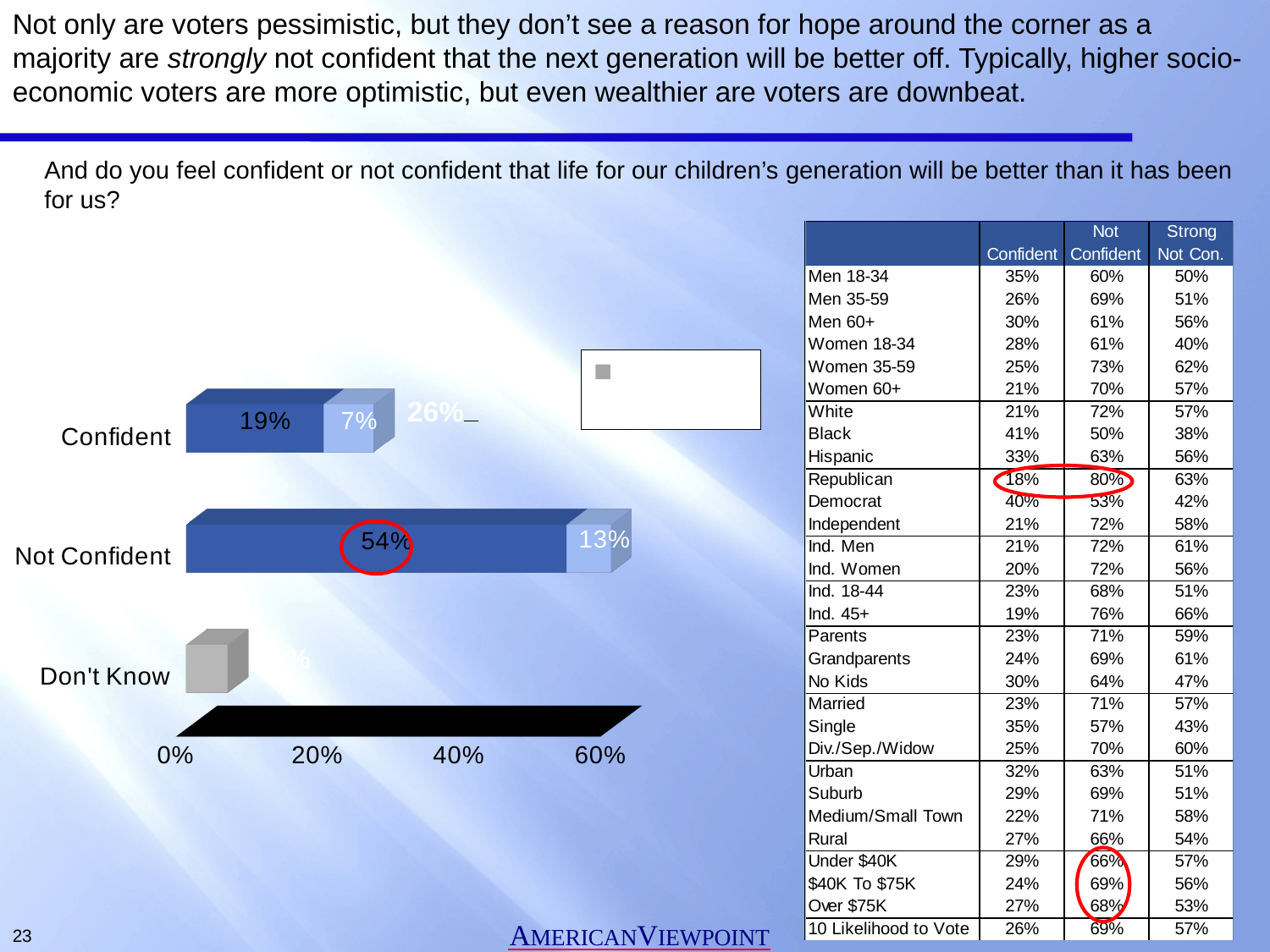
In the bar chart, what is the total shown for the Confident bar? 26% In the bar chart, what value is labelled on the darker blue segment of the Not Confident bar? 54% How many categories does the bar chart show? 3 In the bar chart, what is the difference between the darker blue segment of Not Confident (54%) and the darker blue segment of Confident (19%)? 35 percentage points What kind of chart is shown on the left of the slide? bar chart In the bar chart, what value is labelled on the lighter blue segment of the Not Confident bar? 13% Which category has the shortest bar in the bar chart? Don't Know In the bar chart, what value is labelled on the darker blue segment of the Confident bar? 19% Which category has the longest bar in the bar chart? Not Confident In the bar chart, what value is labelled on the lighter blue segment of the Confident bar? 7% In the bar chart, is the value for Don't Know greater or less than 20%? less In the bar chart, what is the total of the two segments of the Not Confident bar? 67%